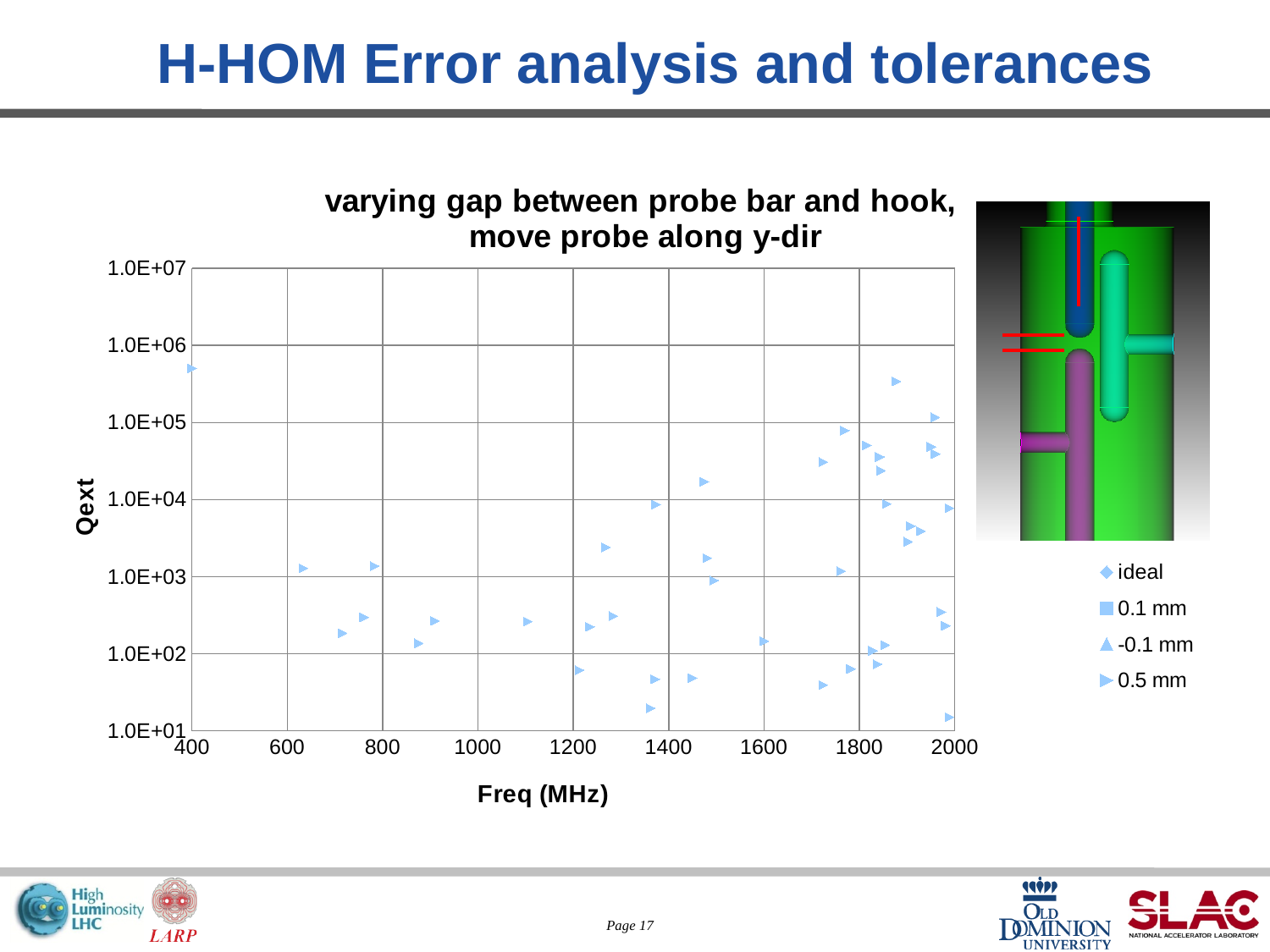
Is the lowest plotted Qext value on the chart greater or less than 1.0E+02? less Is the highest plotted Qext value on the chart greater or less than 1.0E+06? less Is the Qext value of the point plotted near 400 MHz greater or less than 1.0E+05? greater What is the maximum value shown on the y axis of the chart? 1.0E+07 What is the title of the chart? varying gap between probe bar and hook, move probe along y-dir What is the maximum frequency shown on the x axis of the chart? 2000 How many series does the chart legend list? 4 What kind of chart is shown on the slide? scatter chart What is the label of the x axis of the chart? Freq (MHz)